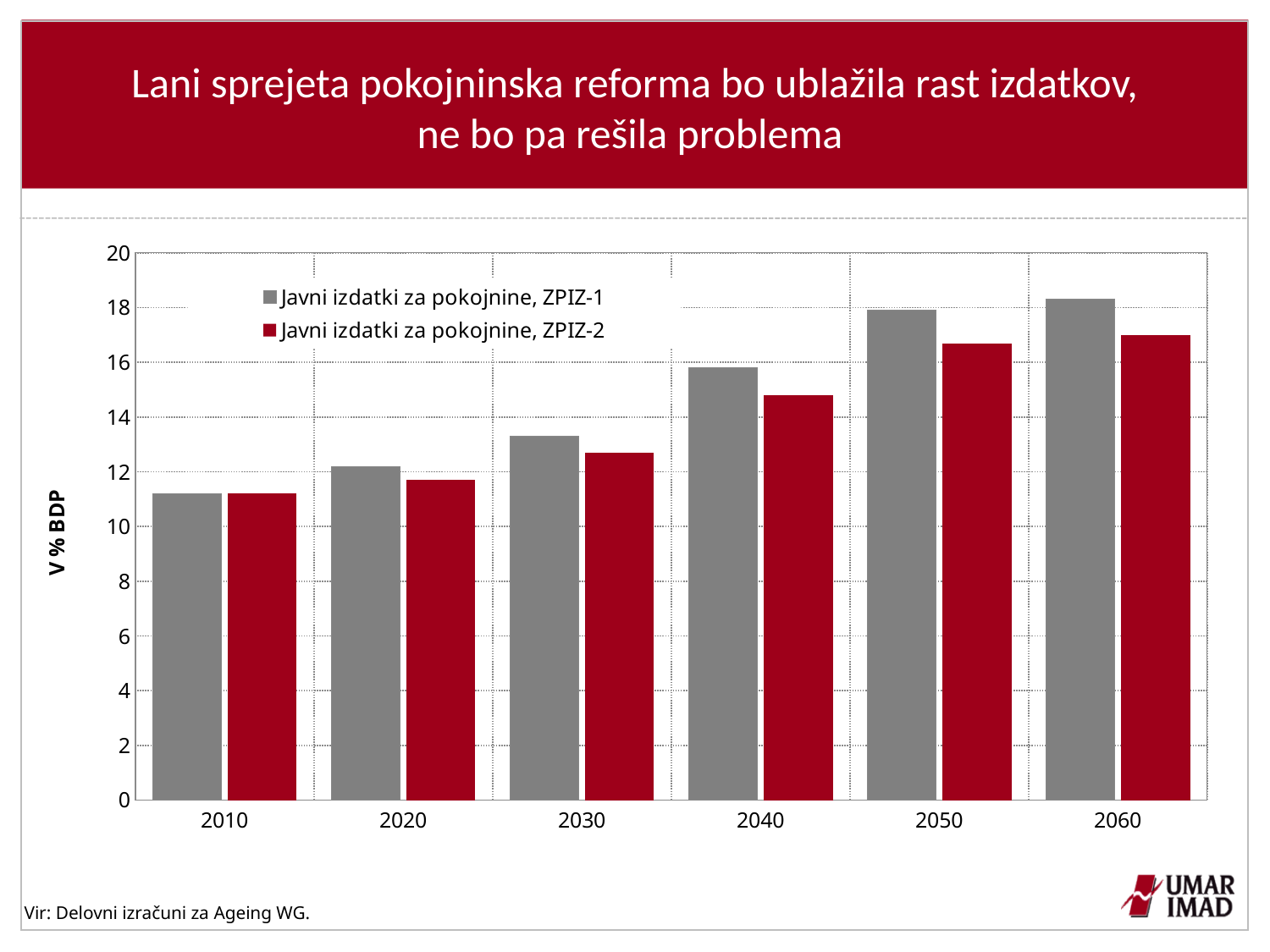
How many series does the legend list? 2 Is the value for Javni izdatki za pokojnine, ZPIZ-1 in 2030 greater or less than 12? greater Is the value for Javni izdatki za pokojnine, ZPIZ-2 in 2060 greater or less than 18? less Do the values for Javni izdatki za pokojnine, ZPIZ-2 rise or fall from 2010 to 2060? rise In 2050, which series has the larger value, ZPIZ-1 or ZPIZ-2? ZPIZ-1 In which year is the value for Javni izdatki za pokojnine, ZPIZ-1 highest? 2060 How many years are shown on the x axis? 6 Is the value for Javni izdatki za pokojnine, ZPIZ-2 in 2020 greater or less than 12? less What kind of chart is shown on the slide? bar chart What is the label on the vertical axis of the chart? V % BDP In which year is the value for Javni izdatki za pokojnine, ZPIZ-2 lowest? 2010